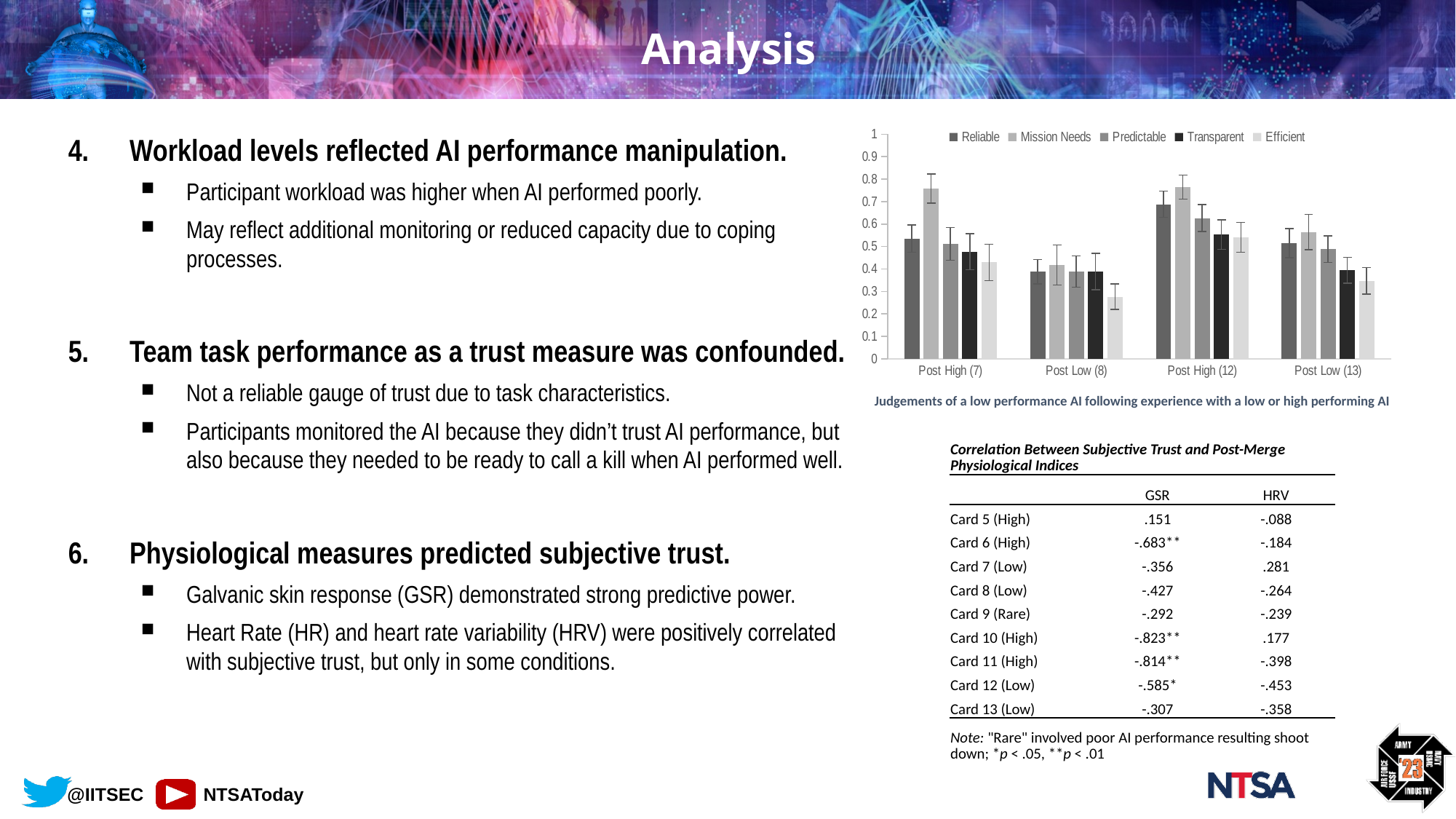
How many series does the chart's legend list? 5 Is the Efficient value for Post Low (8) greater or less than 0.4? less What is the caption printed below the bar chart? Judgements of a low performance AI following experience with a low or high performing AI Which is larger: the Reliable value for Post High (12) or the Reliable value for Post Low (8)? Post High (12) Which series has the lowest bar in the Post Low (8) group? Efficient Is the Reliable value for Post High (12) greater or less than 0.6? greater Which series has the lowest bar in the Post Low (13) group? Efficient Is the Mission Needs value for Post High (7) greater or less than 0.7? greater Which is larger: the Mission Needs value for Post High (7) or the Mission Needs value for Post Low (13)? Post High (7) Which series has the highest bar in the Post High (7) group? Mission Needs What kind of chart is shown on the slide? Bar chart How many categories are shown along the x axis of the chart? 4